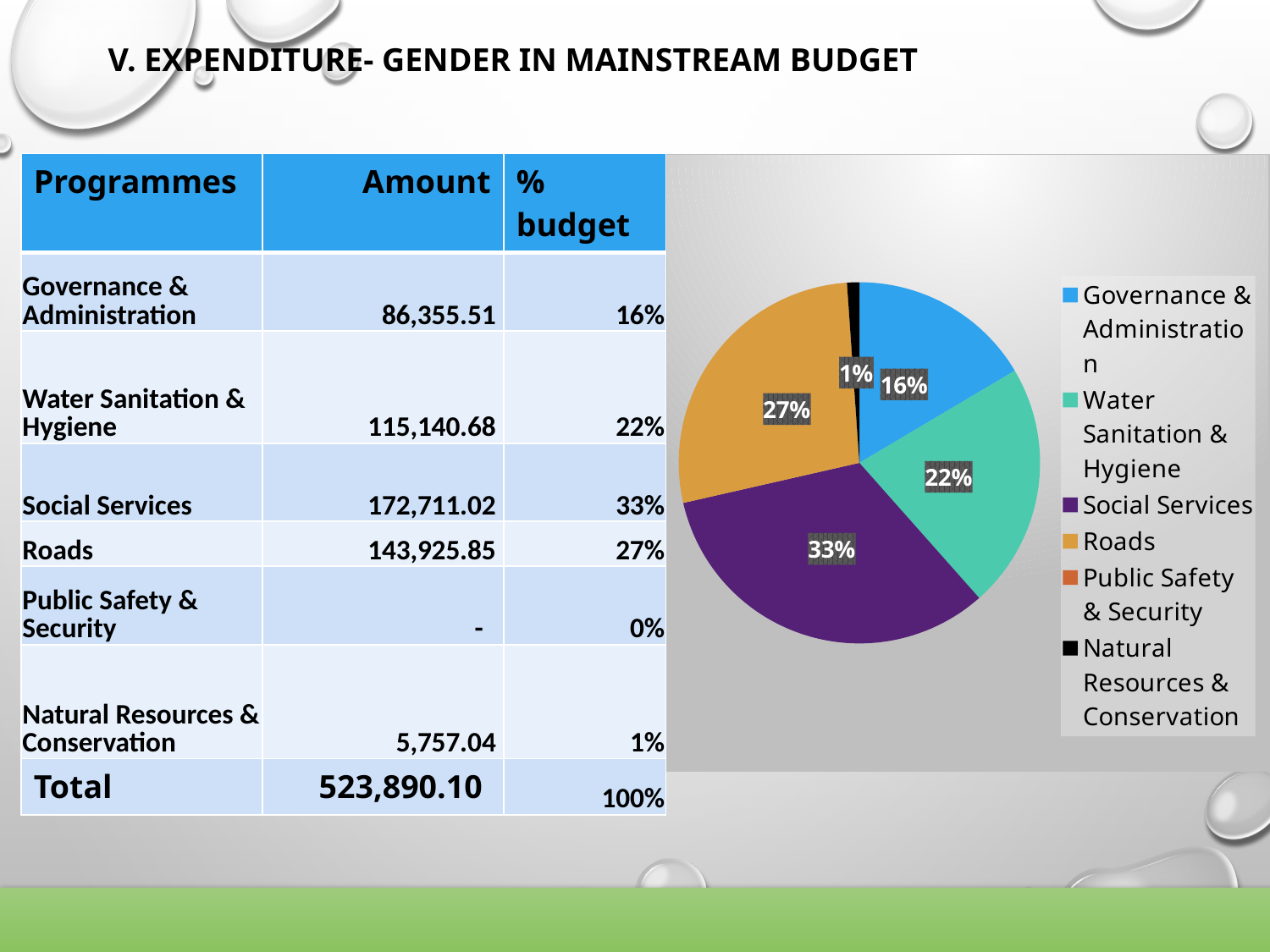
Which category has the largest slice in the pie chart? Social Services In the pie chart, what share does Governance & Administration have? 16% What is the difference in percentage points between the Social Services slice and the Roads slice? 6% In the pie chart, what share does Natural Resources & Conservation have? 1% In the pie chart, what share does Roads have? 27% What type of chart is shown on the slide? Pie chart How many categories does the pie chart's legend list? 6 Which slice is larger in the pie chart, Water Sanitation & Hygiene or Governance & Administration? Water Sanitation & Hygiene Which of the labelled slices in the pie chart is the smallest? Natural Resources & Conservation What colour is the Roads slice in the pie chart? Orange